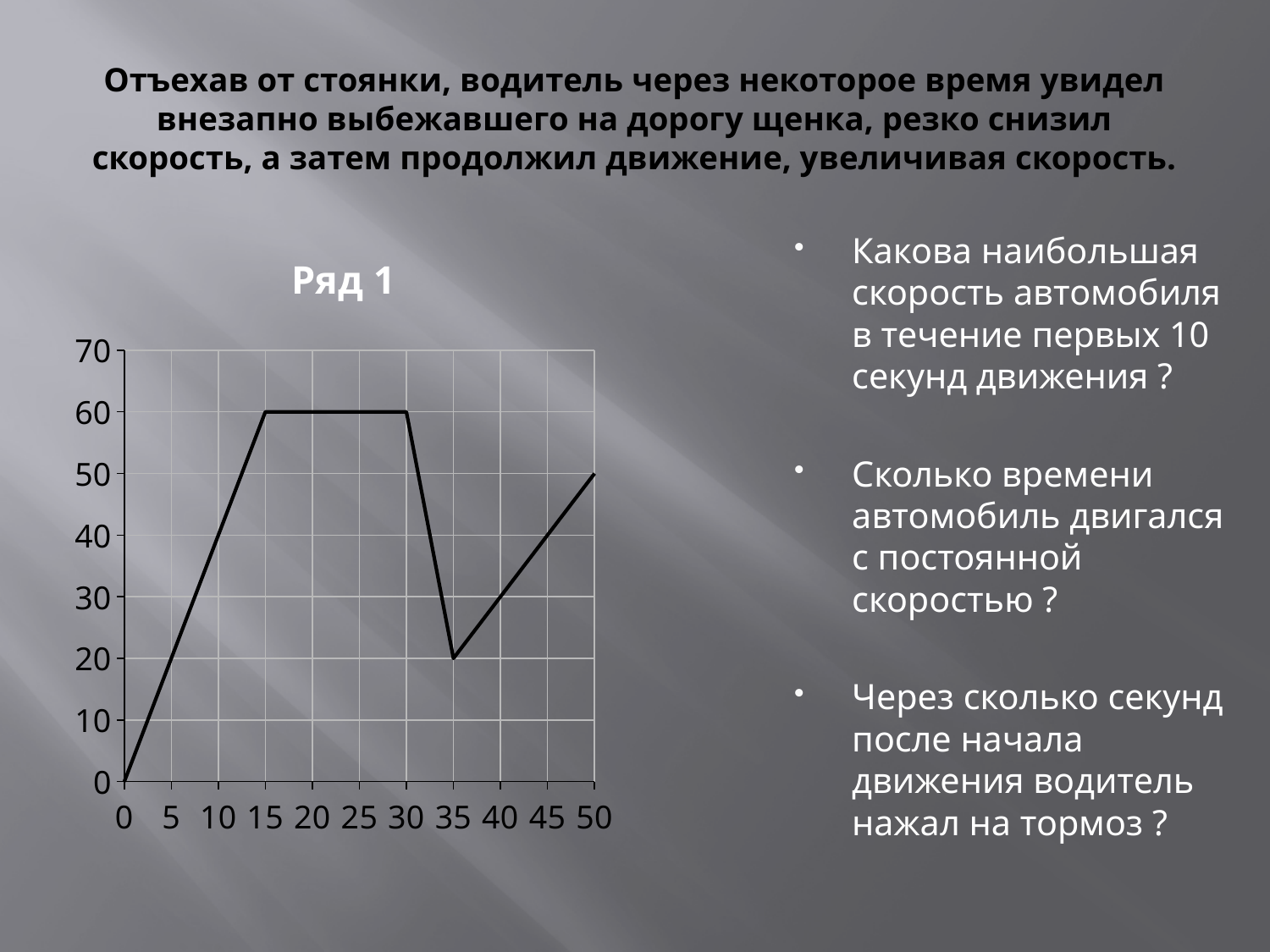
What is the lowest value of the line? 0 Which is larger, the value at x = 15 or the value at x = 50? x = 15 What is the highest value reached by the line? 60 What is the value of the line at x = 35? 20 What is the value of the line at x = 15? 60 What is the value of the line at x = 0? 0 Is the value at x = 10 greater or less than 30? greater What is the value of the line at x = 50? 50 What is the difference between the value at x = 30 and the value at x = 35? 40 Does the line rise or fall between x = 35 and x = 50? rise What kind of chart is shown on the slide? line chart What is the title of the chart? Ряд 1